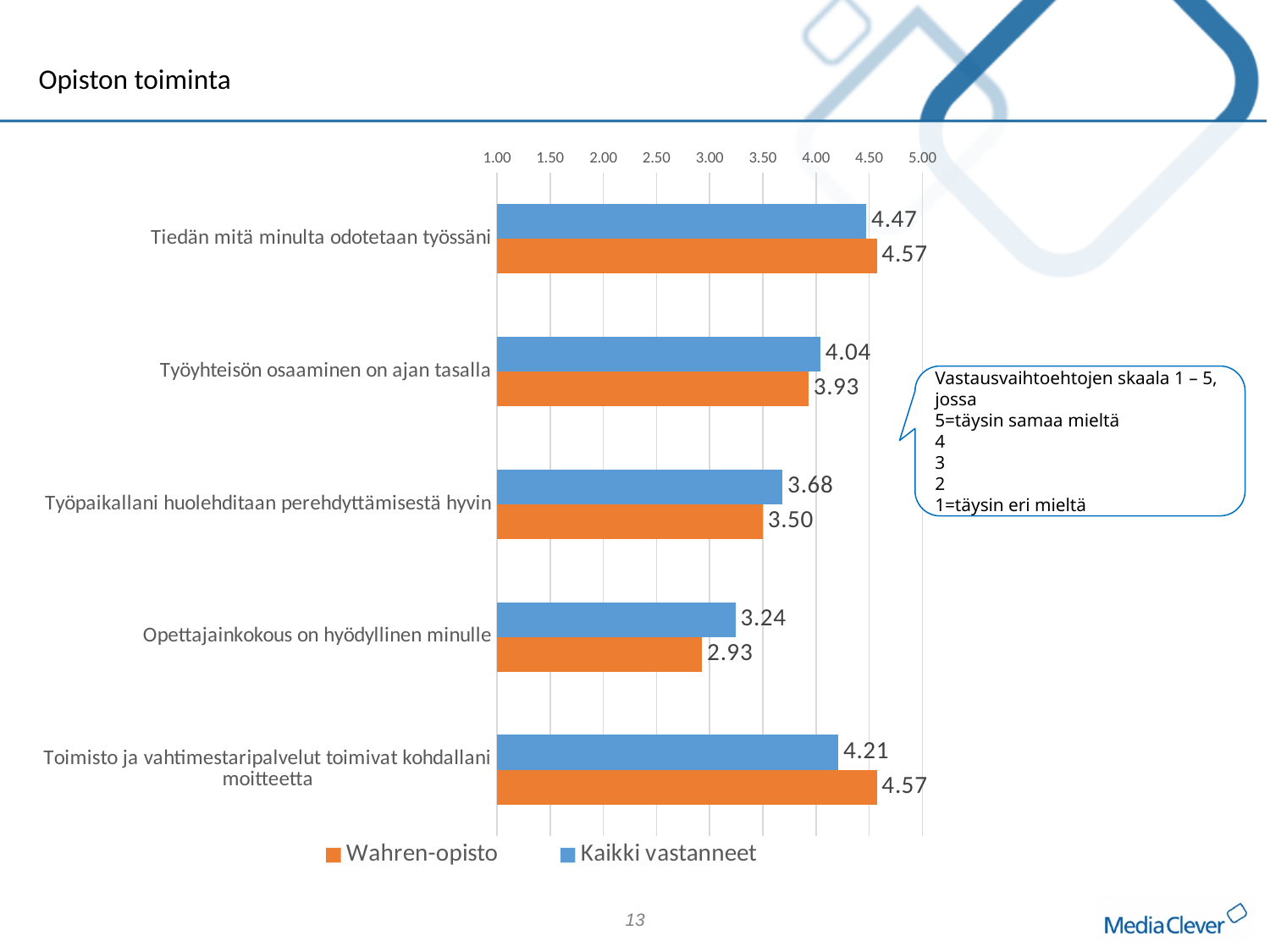
What is the Wahren-opisto value for "Tiedän mitä minulta odotetaan työssäni"? 4.57 What is the difference between the Wahren-opisto and Kaikki vastanneet values for "Toimisto ja vahtimestaripalvelut toimivat kohdallani moitteetta"? 0.36 How many categories are shown in the chart? 5 Is the Wahren-opisto value for "Opettajainkokous on hyödyllinen minulle" greater or less than 3.00? less What kind of chart is shown on the slide? bar chart Which colour represents the Wahren-opisto series? orange What is the Wahren-opisto value for "Työpaikallani huolehditaan perehdyttämisestä hyvin"? 3.50 For "Työyhteisön osaaminen on ajan tasalla", which series has the larger value, Wahren-opisto or Kaikki vastanneet? Kaikki vastanneet What is the Kaikki vastanneet value for "Opettajainkokous on hyödyllinen minulle"? 3.24 Which category has the lowest Wahren-opisto value? Opettajainkokous on hyödyllinen minulle How many series does the legend list? 2 Which category has the highest Kaikki vastanneet value? Tiedän mitä minulta odotetaan työssäni